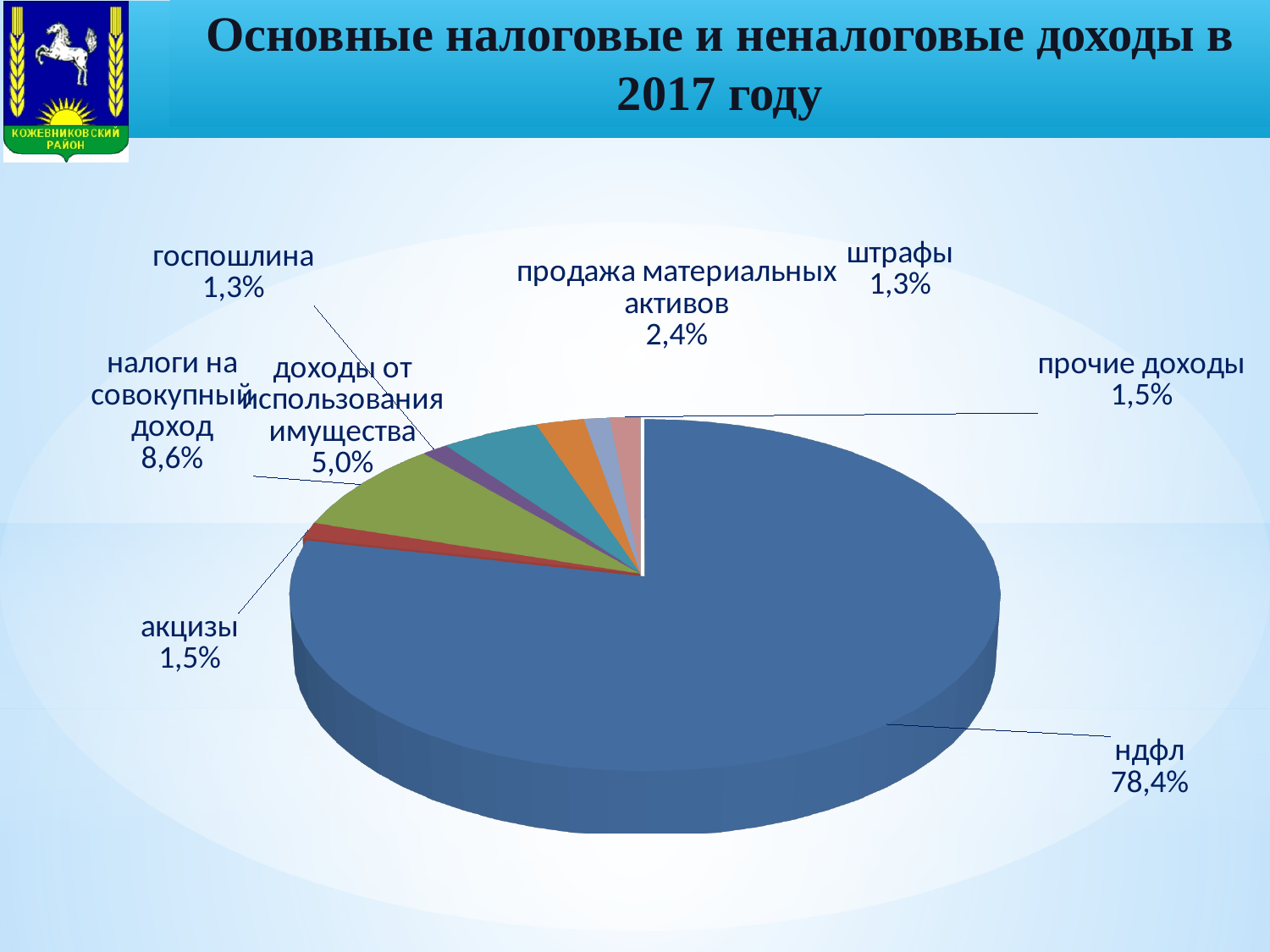
Which is larger: налоги на совокупный доход or доходы от использования имущества? налоги на совокупный доход What is the value shown for налоги на совокупный доход? 8,6% What type of chart is shown on the slide? pie chart What is the value shown for доходы от использования имущества? 5,0% What is the value shown for продажа материальных активов? 2,4% What is the value shown for штрафы? 1,3% What share of the pie does ндфл account for? 78,4% What is the title of the chart on the slide? Основные налоговые и неналоговые доходы в 2017 году What is the value shown for акцизы? 1,5% How many categories (slices) are shown in the pie chart? 8 Which category has the largest slice of the pie? ндфл What is the difference in percentage points between ндфл and налоги на совокупный доход? 69,8